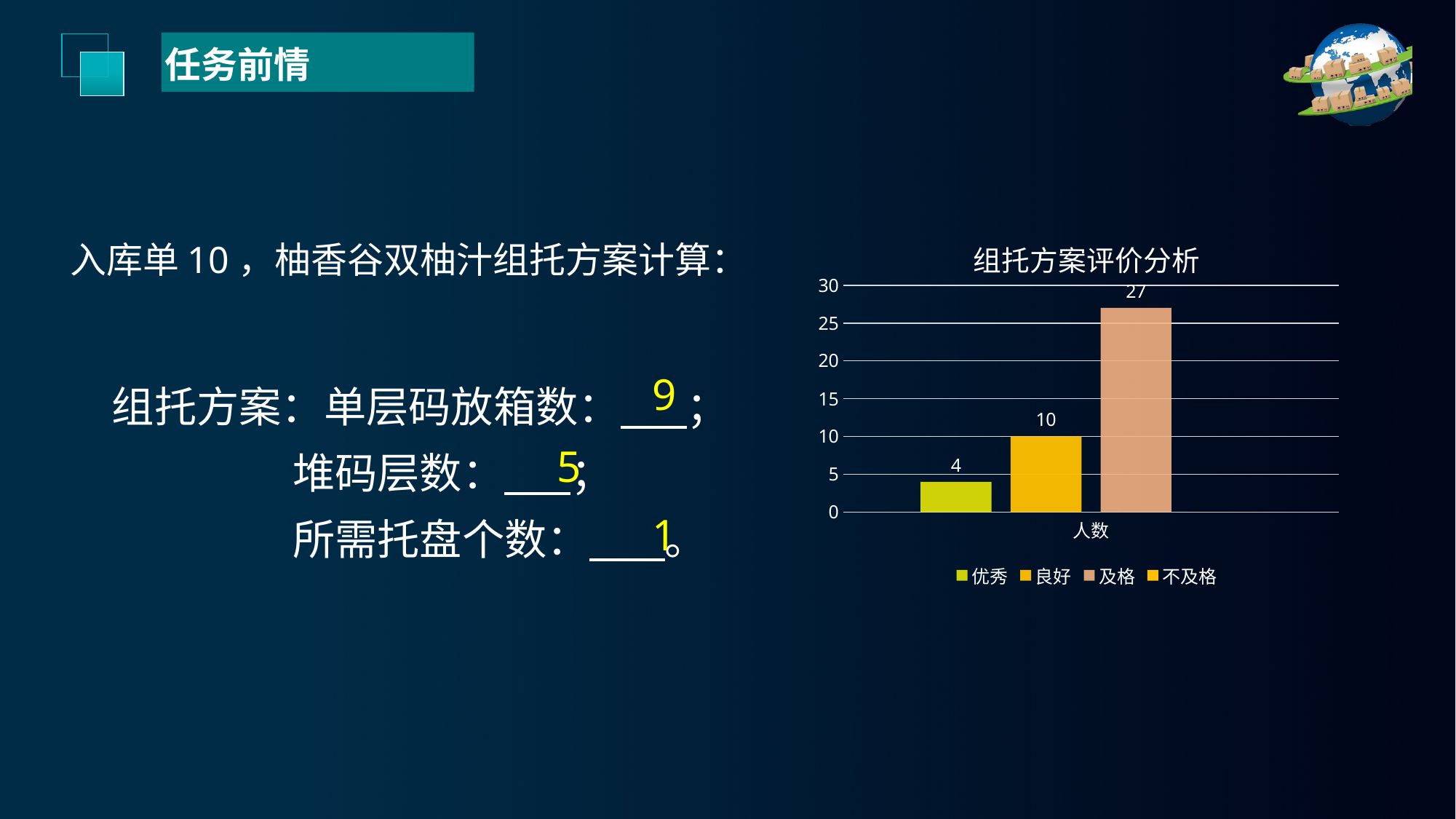
In the 组托方案评价分析 chart, which is larger, the 优秀 value or the 良好 value? 良好 What kind of chart is 组托方案评价分析? bar chart What is the category label on the x axis of the 组托方案评价分析 chart? 人数 What is the value of the 良好 bar in the 组托方案评价分析 chart? 10 Which series has the highest bar in the 组托方案评价分析 chart? 及格 What is the value of the 及格 bar in the 组托方案评价分析 chart? 27 What is the value of the 优秀 bar in the 组托方案评价分析 chart? 4 What is the difference between the 良好 and 优秀 values in the 组托方案评价分析 chart? 6 What is the difference between the 及格 and 良好 values in the 组托方案评价分析 chart? 17 What is the title of the chart on the slide? 组托方案评价分析 How many series does the legend of the 组托方案评价分析 chart list? 4 Is the value for 及格 in the 组托方案评价分析 chart greater or less than 25? greater